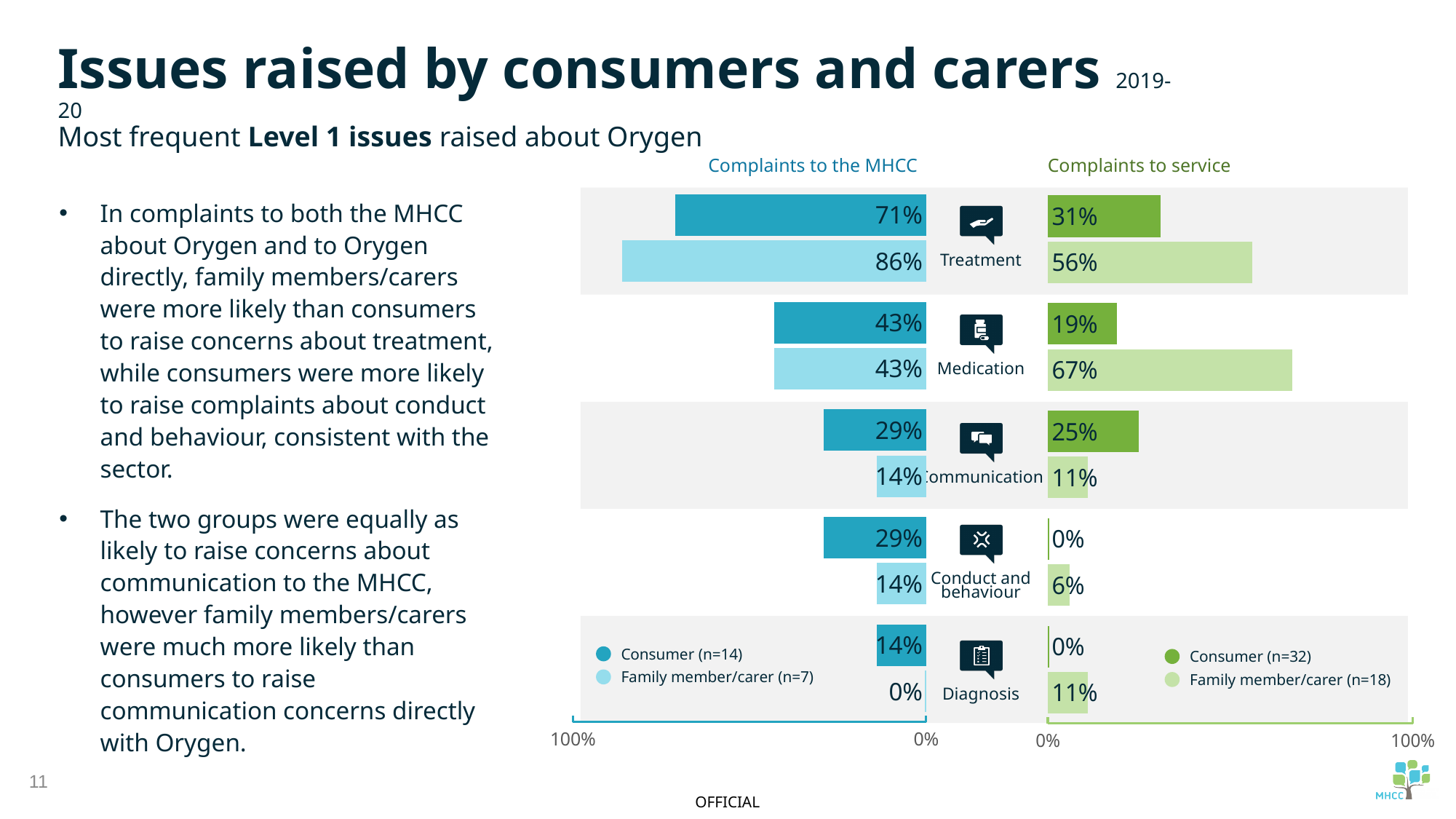
How many series does the legend of the 'Complaints to service' chart list? 2 In the 'Complaints to service' chart, what percentage of family member/carer complaints were about Medication? 67% In the 'Complaints to the MHCC' chart, what percentage of family member/carer complaints were about Treatment? 86% In the 'Complaints to service' chart, what percentage of consumer complaints were about Conduct and behaviour? 0% In the 'Complaints to the MHCC' chart, what is the difference between the family member/carer and consumer values for Treatment? 15% What type of chart is the 'Complaints to service' chart? Bar chart How many issue categories are shown in the 'Complaints to the MHCC' chart? 5 In the 'Complaints to service' chart, what is the difference between the family member/carer and consumer values for Medication? 48% In the 'Complaints to service' chart, which issue has the highest value for consumers? Treatment In the 'Complaints to the MHCC' chart, which issue has the highest value for family member/carer? Treatment In the 'Complaints to the MHCC' chart, what percentage of consumer complaints were about Treatment? 71% In the 'Complaints to the MHCC' chart, which is larger for Communication: the consumer value or the family member/carer value? Consumer